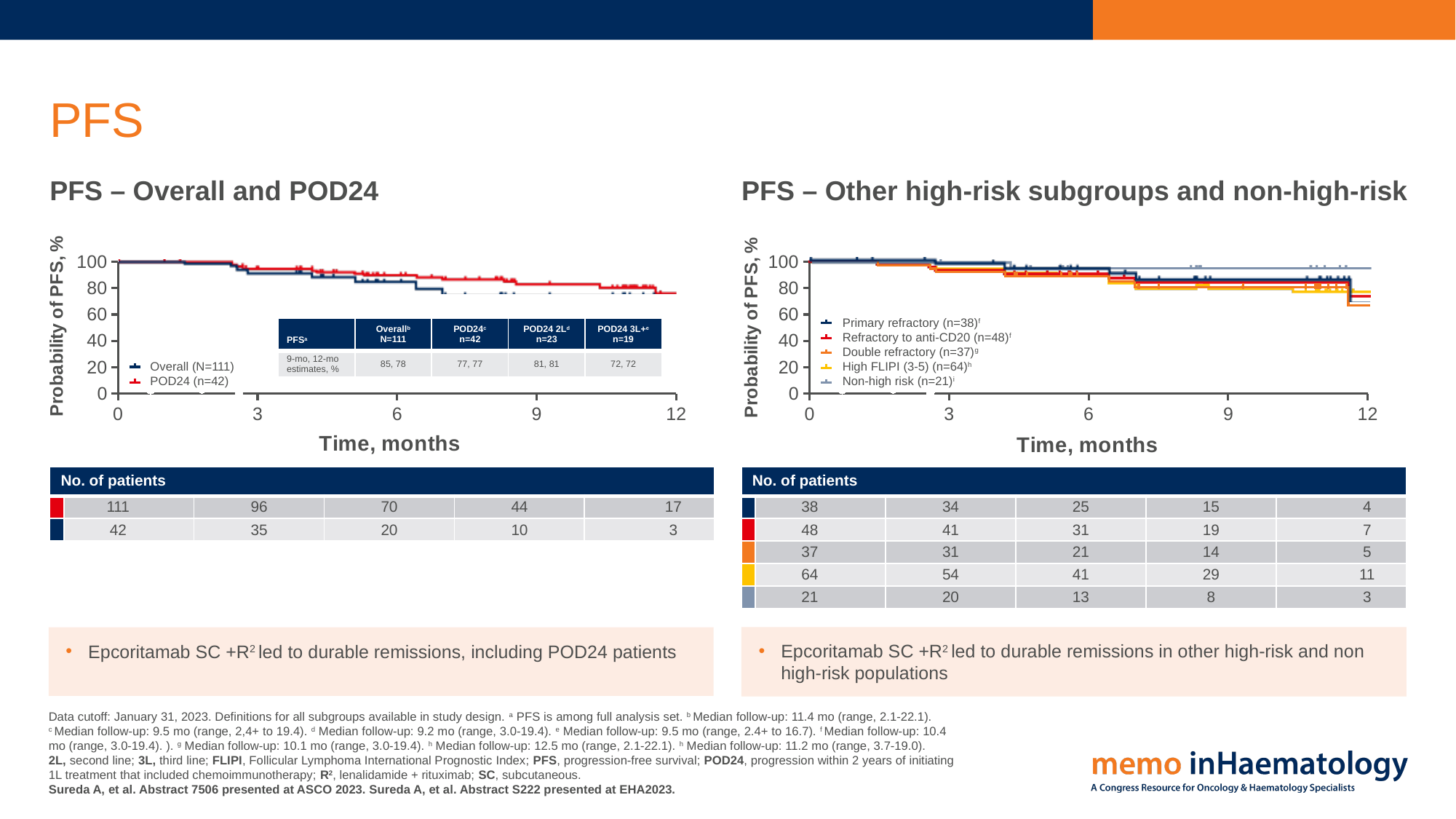
On the right chart (PFS – Other high-risk subgroups and non-high-risk), how many series does the legend list? 5 On the right chart (PFS – Other high-risk subgroups and non-high-risk), how many patients are in the High FLIPI (3-5) group according to the legend? 64 On the left chart (PFS – Overall and POD24), how many series does the legend list? 2 On the left chart (PFS – Overall and POD24), what is the 9-month PFS estimate for the POD24 group according to the inset table? 77 On the left chart (PFS – Overall and POD24), what is the 12-month PFS estimate for the POD24 3L+ group according to the inset table? 72 On the left chart (PFS – Overall and POD24), what is the 12-month PFS estimate for the Overall group according to the inset table? 78 On the left chart (PFS – Overall and POD24), do the PFS curves rise or fall as time increases along the x axis? fall On the right chart (PFS – Other high-risk subgroups and non-high-risk), which subgroup in the legend has the largest number of patients? High FLIPI (3-5) (n=64) On the left chart (PFS – Overall and POD24), what is the difference between the 9-month PFS estimates for the Overall and POD24 groups? 8 On the left chart (PFS – Overall and POD24), is the Overall curve at 12 months greater or less than 60? greater On the left chart (PFS – Overall and POD24), how many patients are in the Overall group according to the legend? 111 What kind of chart is the left chart (PFS – Overall and POD24)? line chart